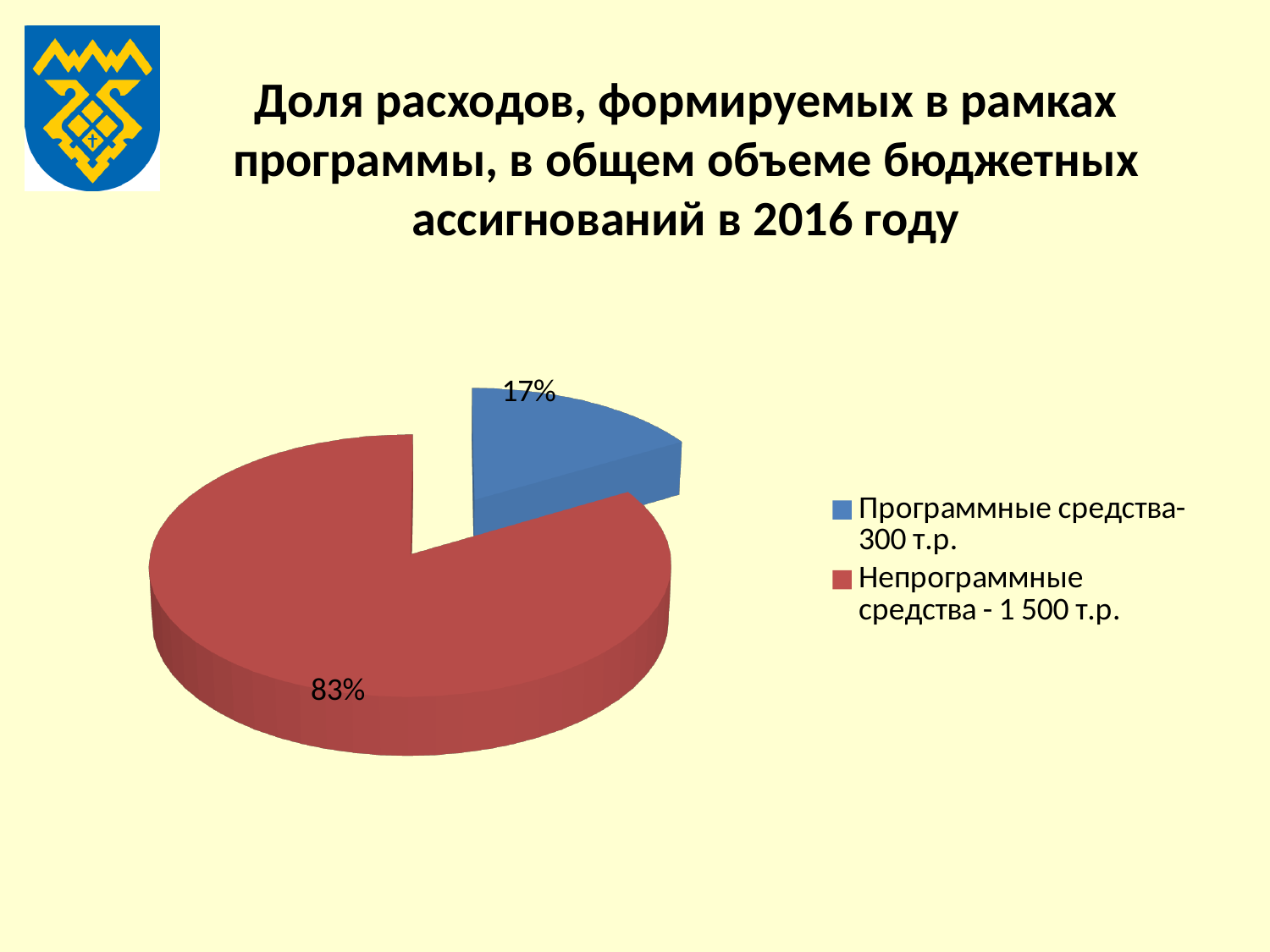
What share of the pie is labelled for Непрограммные средства? 83% Which slice of the pie is the largest? Непрограммные средства Which is larger: the share for Программные средства or the share for Непрограммные средства? Непрограммные средства How many entries does the legend list? 2 What kind of chart is shown on the slide? pie chart Which slice of the pie is the smallest? Программные средства What amount in т.р. does the legend give for Программные средства? 300 т.р. How many slices does the pie chart have? 2 What colour is the slice for Непрограммные средства? red What is the difference in percentage points between the Непрограммные средства slice and the Программные средства slice? 66 What share of the pie is labelled for Программные средства? 17% What amount in т.р. does the legend give for Непрограммные средства? 1 500 т.р.